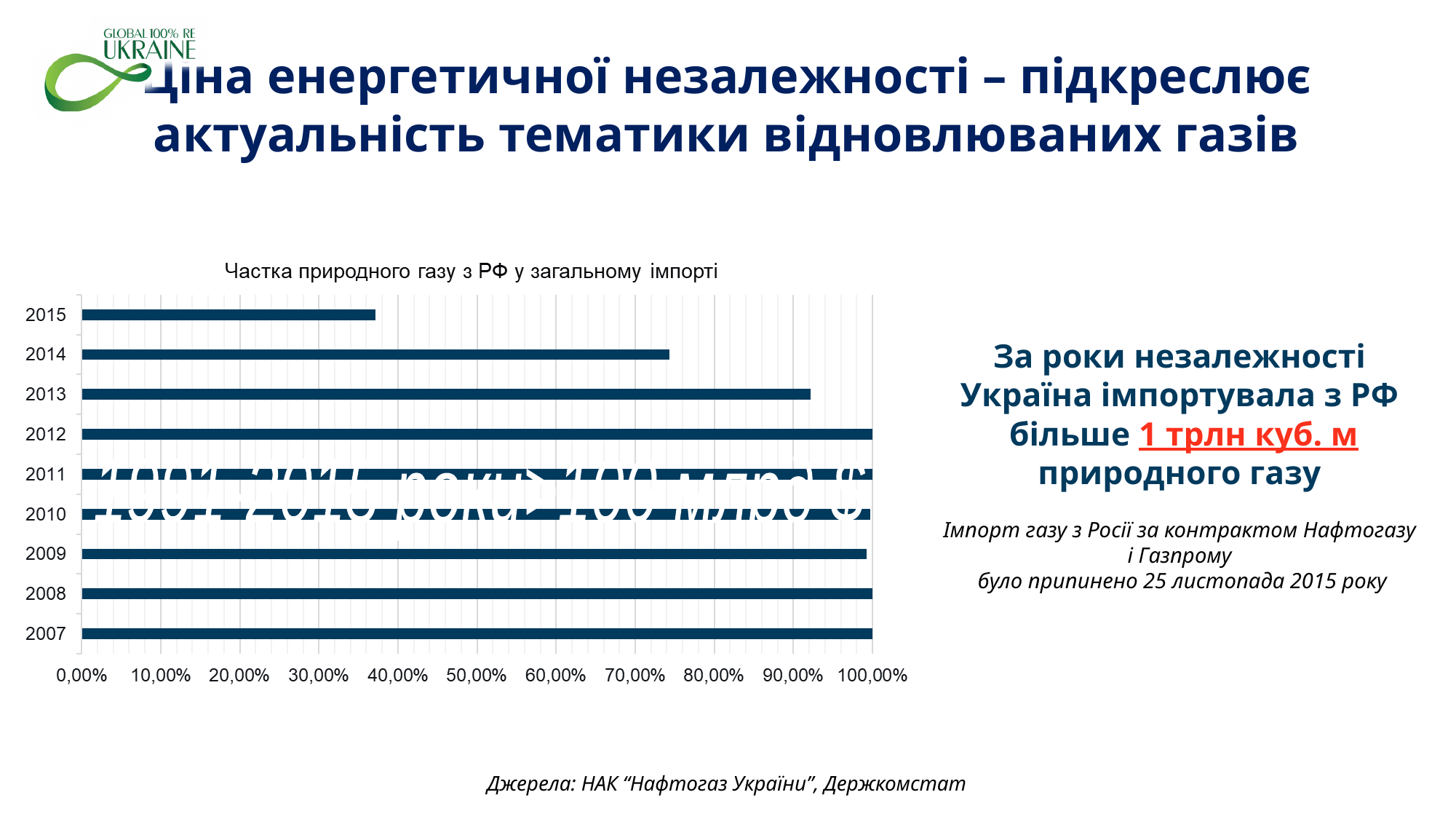
Which is larger, the value for 2014 or the value for 2015? 2014 What is the highest value shown on the horizontal axis of the chart? 100,00% Is the value for 2013 greater or less than 90,00%? greater Is the value for 2014 greater or less than 80,00%? less Which year has the lowest share of natural gas from the Russian Federation in total imports? 2015 How many years are shown on the chart? 9 Is the value for 2015 greater or less than 40,00%? less Which is larger, the value for 2013 or the value for 2014? 2013 What kind of chart is shown on the slide? bar chart Do the values rise or fall from 2012 to 2015? fall What is the title of the chart? Частка природного газу з РФ у загальному імпорті